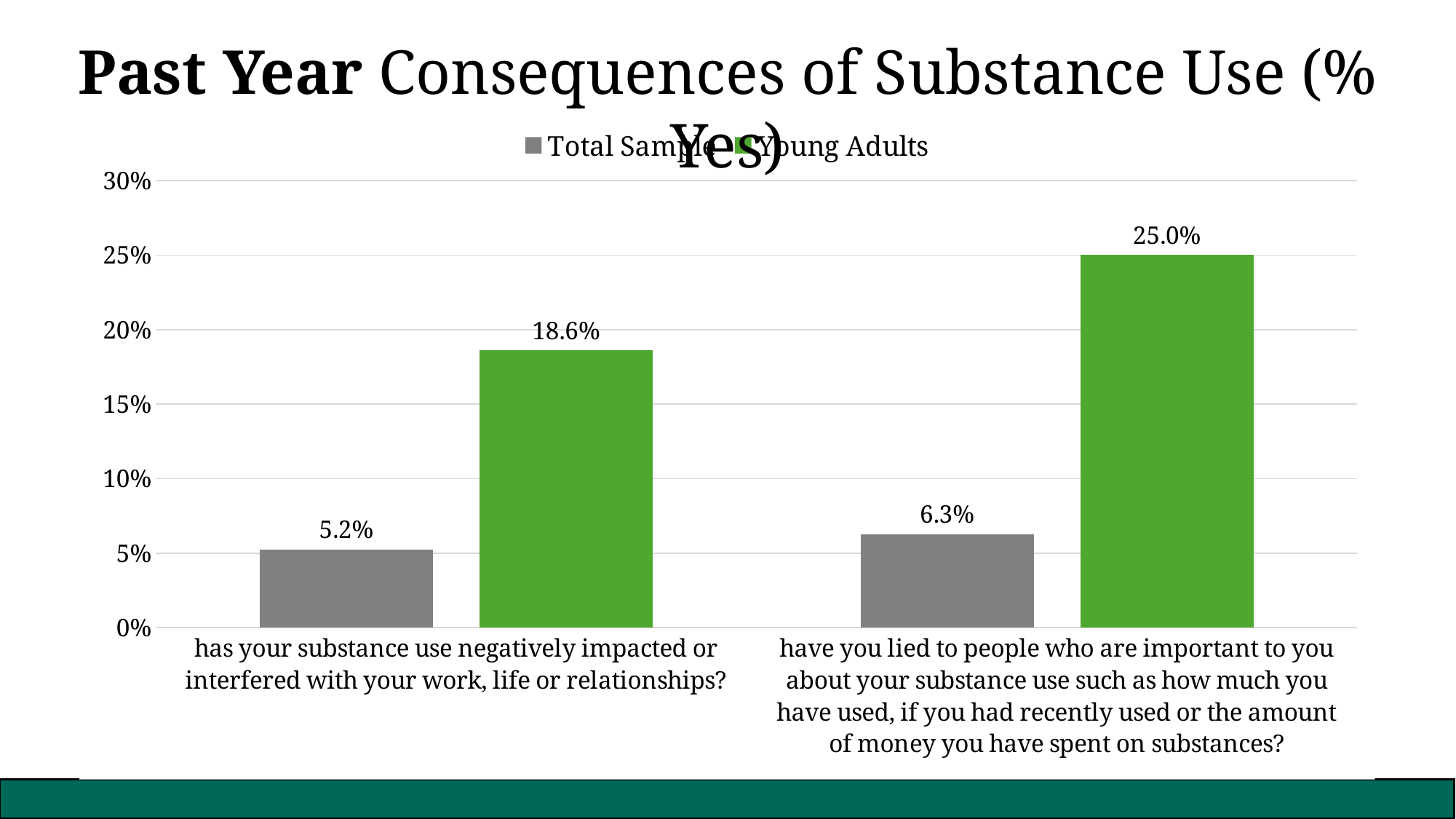
What is the Total Sample value for "has your substance use negatively impacted or interfered with your work, life or relationships?" 5.2% How many series does the legend list? 2 What is the Total Sample value for the question about lying to people who are important to you about your substance use? 6.3% What kind of chart is shown on the slide? bar chart What is the difference between the Young Adults and Total Sample values for the question about lying to people who are important to you? 18.7% What is the Young Adults value for the question about lying to people who are important to you about your substance use? 25.0% How many question categories are shown on the x axis? 2 Which series has the highest value on the chart? Young Adults Which bar has the lowest value on the chart? Total Sample for "has your substance use negatively impacted or interfered with your work, life or relationships?" (5.2%) Is the Young Adults value for the question about lying to people who are important to you greater or less than 20%? greater What is the Young Adults value for "has your substance use negatively impacted or interfered with your work, life or relationships?" 18.6% Which colour represents the Young Adults series? green